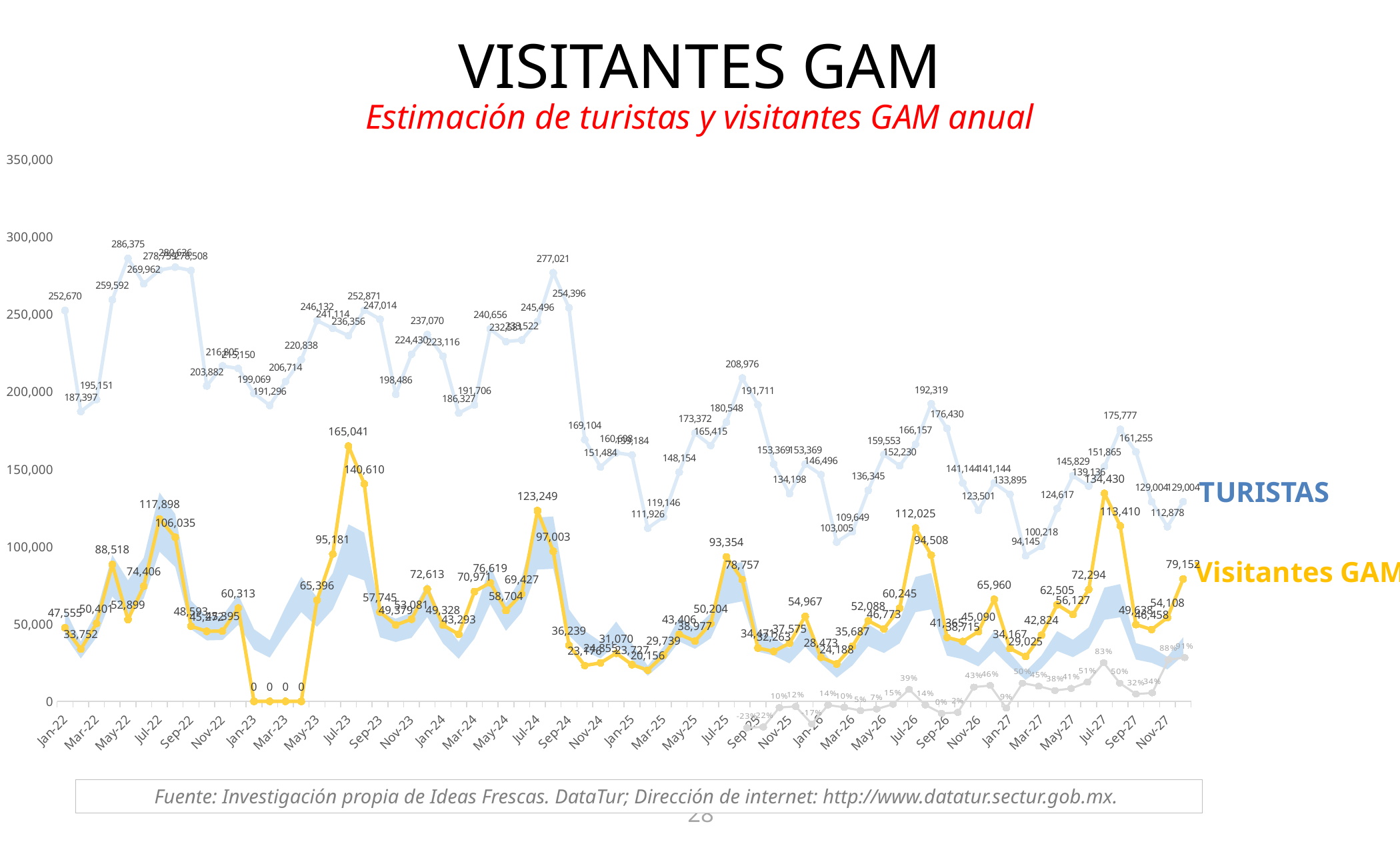
What is the lowest value of the TURISTAS series? 94,145 What is the TURISTAS value for Aug-24? 277,021 What is the highest value of the Visitantes GAM series? 165,041 Which is larger, the Visitantes GAM value for Jul-24 or for Jul-25? Jul-24 What is the TURISTAS value for Jan-22? 252,670 What type of chart is shown on the slide? line chart What is the Visitantes GAM value for Nov-27? 54,108 What are the two series labelled on the right side of the chart? TURISTAS and Visitantes GAM What is the difference between the TURISTAS value and the Visitantes GAM value in Jul-23? 71,315 Is the TURISTAS value for Feb-25 greater or less than 150,000? less In which month does the TURISTAS series reach its highest value? May-22 What is the Visitantes GAM value for Jul-23? 165,041